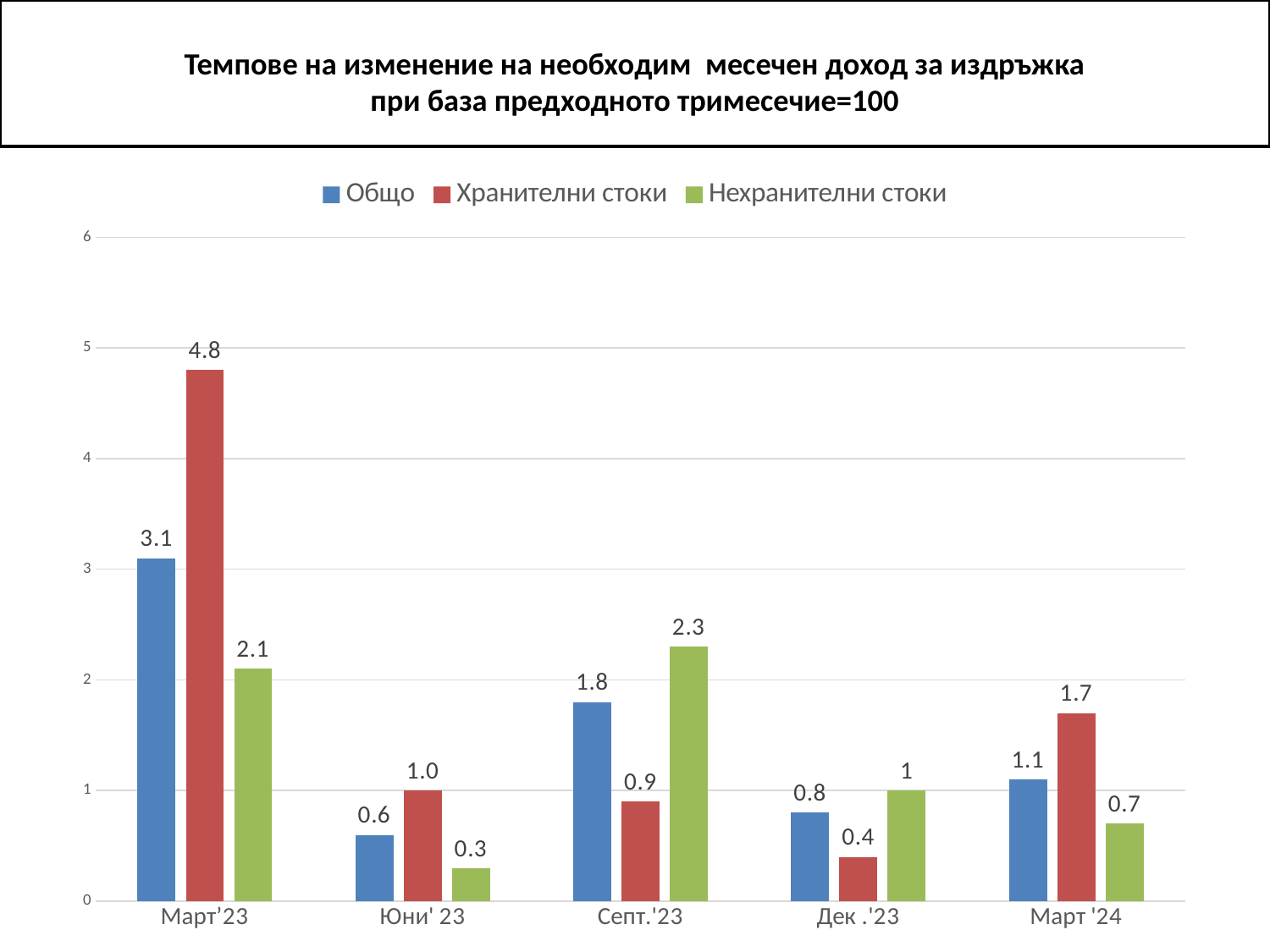
Which period has the highest value for Общо? Март'23 How many periods are shown on the x axis? 5 How many series does the legend list? 3 Which is larger in Септ.'23: Общо or Нехранителни стоки? Нехранителни стоки Does the value for Хранителни стоки rise or fall from Март'23 to Юни' 23? fall What is the difference between Хранителни стоки and Нехранителни стоки in Март'23? 2.7 Which period has the lowest value for Нехранителни стоки? Юни' 23 What is the value for Хранителни стоки in Март'23? 4.8 What kind of chart is shown on the slide? bar chart Which colour represents Хранителни стоки in the legend? red What is the value for Общо in Септ.'23? 1.8 What is the value for Нехранителни стоки in Дек.'23? 1